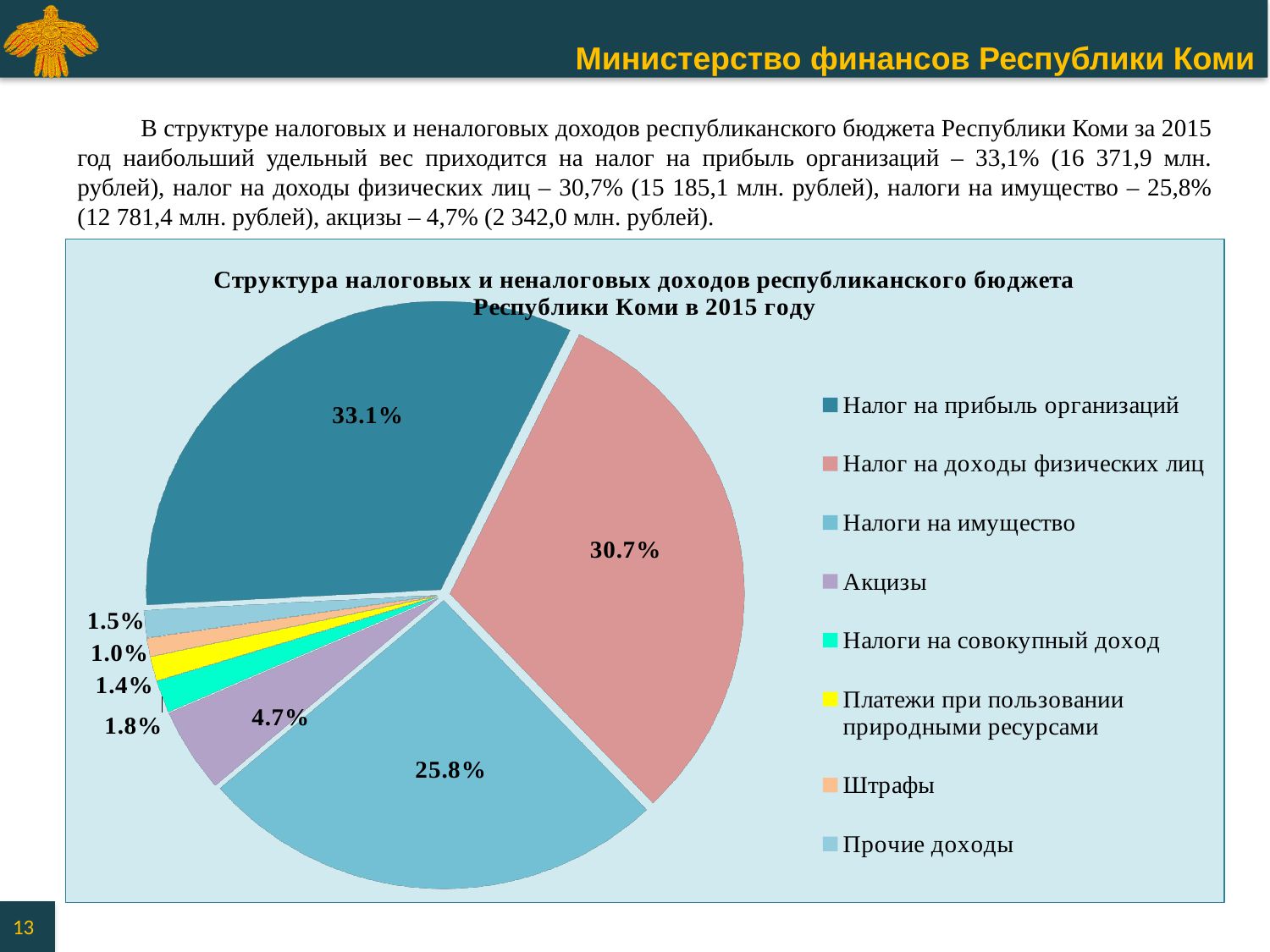
What share of the pie does "Налог на прибыль организаций" have? 33.1% What is the difference between the shares of "Налог на прибыль организаций" and "Налог на доходы физических лиц"? 2.4% Which category has the largest slice of the pie? Налог на прибыль организаций What is the value shown for "Акцизы"? 4.7% What is the value shown for "Налоги на совокупный доход"? 1.8% What is the title of the chart? Структура налоговых и неналоговых доходов республиканского бюджета Республики Коми в 2015 году What is the value shown for "Налог на доходы физических лиц"? 30.7% How many categories does the pie chart have? 8 Which is larger: the share of "Налоги на имущество" or the share of "Акцизы"? Налоги на имущество What is the value shown for "Налоги на имущество"? 25.8% Which category has the smallest slice of the pie? Штрафы What kind of chart is shown on the slide? pie chart